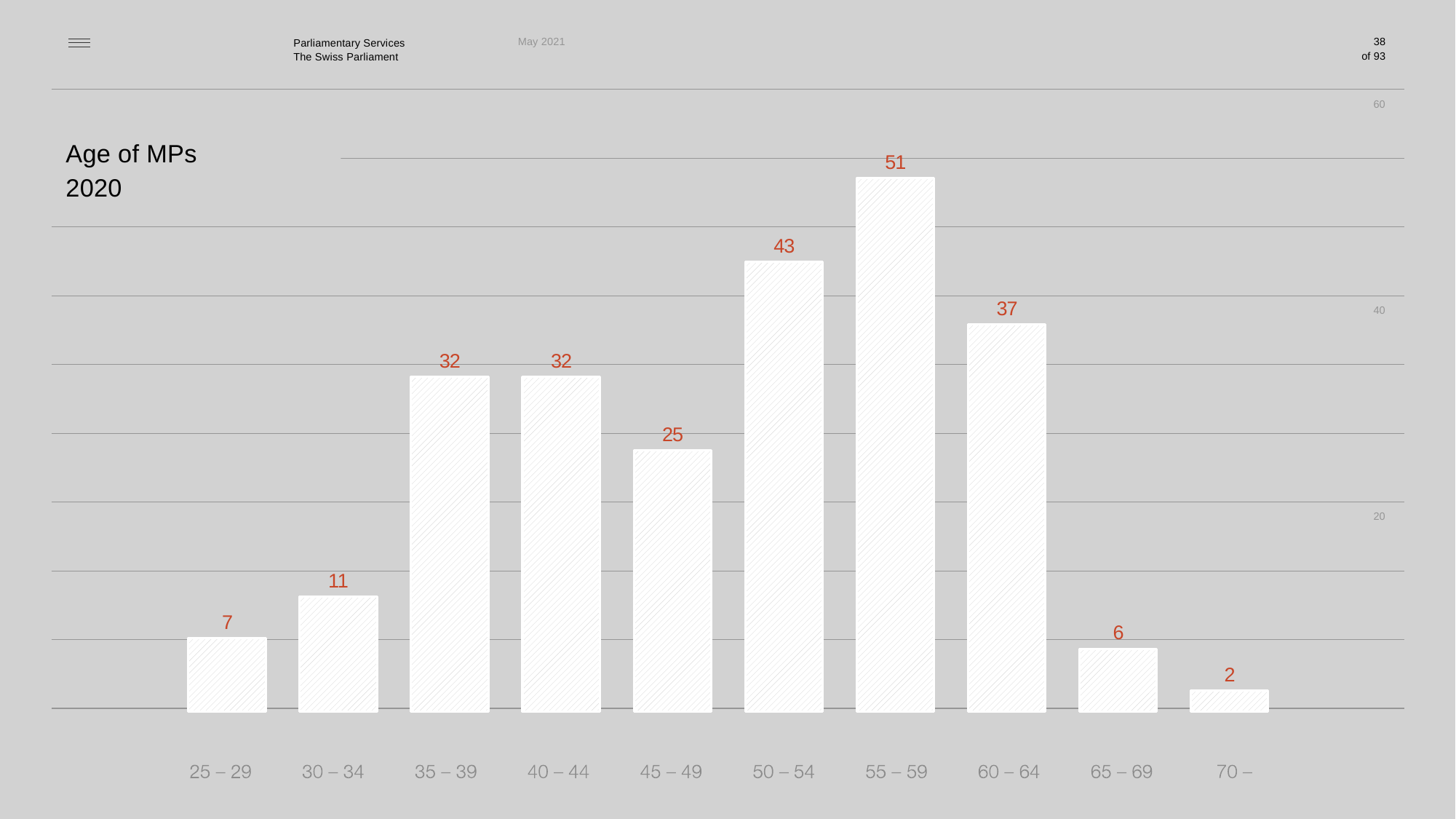
What is the number of MPs aged 45 – 49? 25 Which age group has the highest number of MPs? 55 – 59 How many age groups are shown on the chart? 10 What kind of chart is shown on the slide? Bar chart Which age group has the lowest number of MPs? 70 – What is the number of MPs aged 55 – 59? 51 Is the value for the 50 – 54 age group greater or less than 40? greater What is the number of MPs aged 25 – 29? 7 Which age group has more MPs, 30 – 34 or 45 – 49? 45 – 49 What is the difference between the number of MPs aged 55 – 59 and those aged 50 – 54? 8 What is the title of the chart? Age of MPs 2020 What is the difference between the number of MPs aged 60 – 64 and those aged 65 – 69? 31